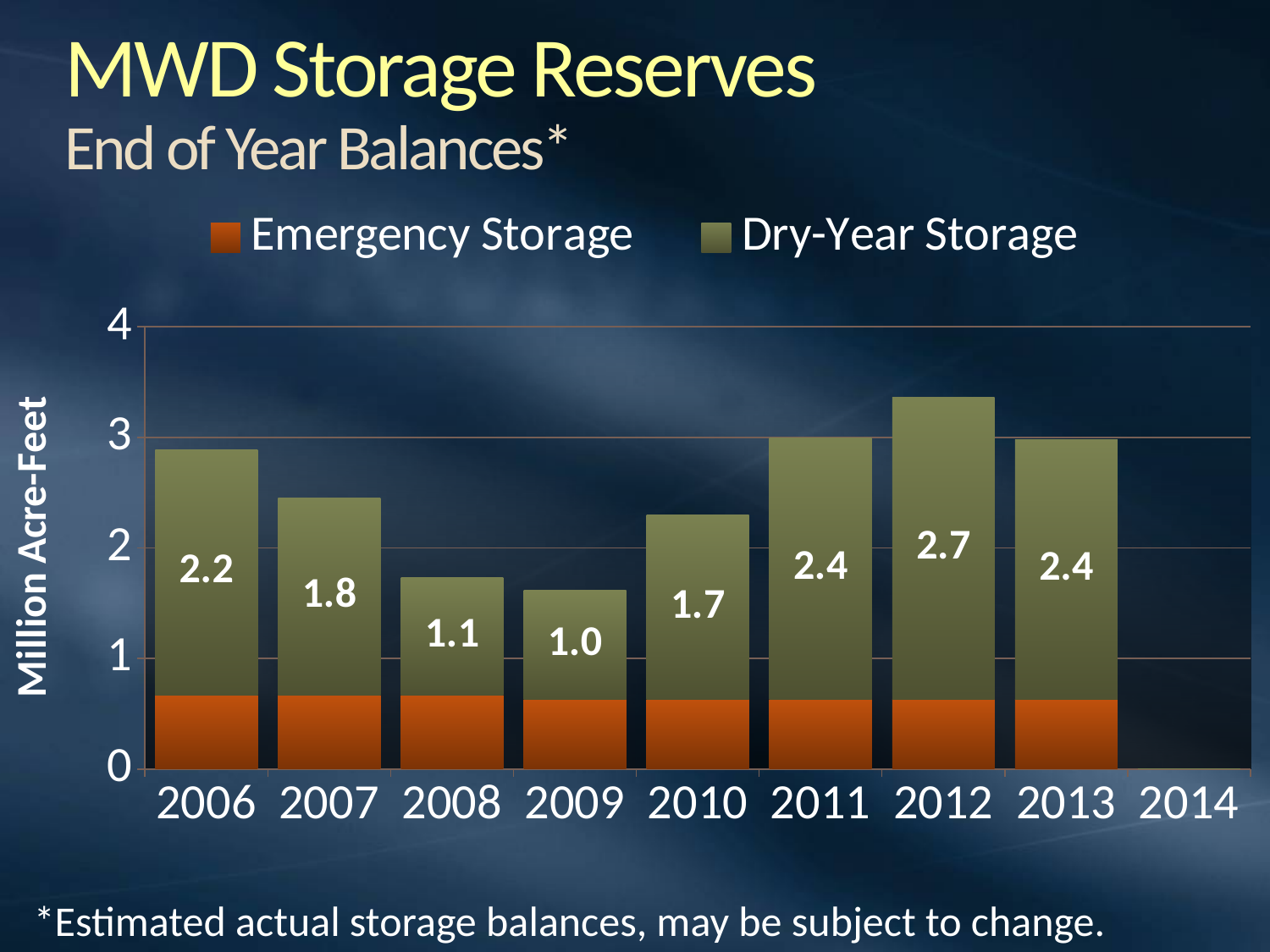
Which year has the larger Dry-Year Storage value, 2010 or 2011? 2011 Which year has the highest Dry-Year Storage value? 2012 What is the Dry-Year Storage value for 2009? 1.0 What kind of chart is shown on the slide? Stacked bar chart How many series does the legend list? 2 Is the total stacked bar for 2012 greater or less than 3? greater What is the Dry-Year Storage value for 2007? 1.8 Is the Emergency Storage value for 2006 greater or less than 1? less What is the label on the vertical axis? Million Acre-Feet What is the difference between the Dry-Year Storage values for 2012 and 2009? 1.7 What is the Dry-Year Storage value for 2012? 2.7 Which year has the lowest Dry-Year Storage value? 2009